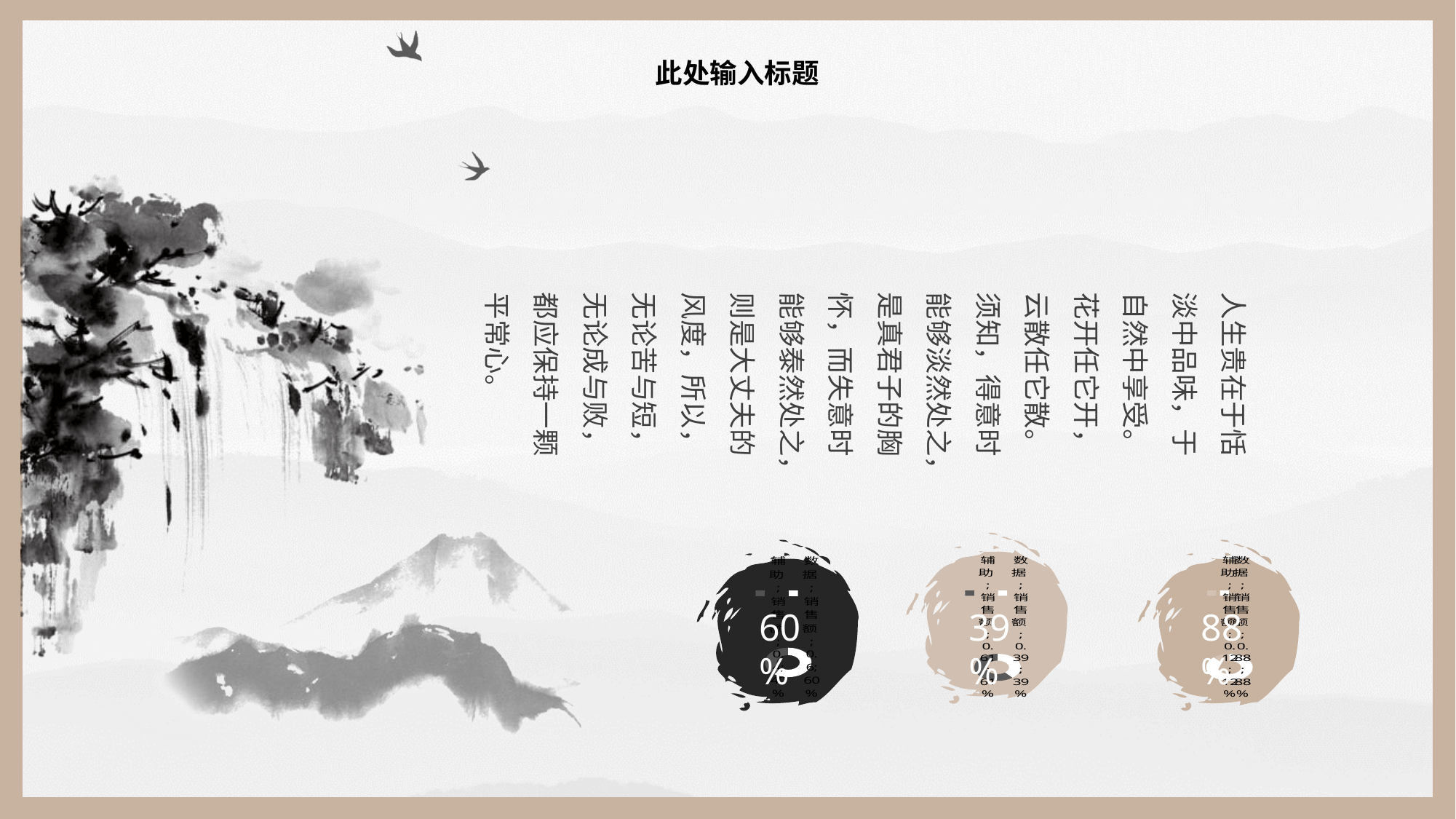
Is the percentage shown on the middle chart greater or less than 50%? less What colour is the left chart's circle compared with the other two? Dark grey/black; the other two are brown Which of the three charts shows the highest percentage? The right chart (88%) Which is larger, the percentage on the left chart or the percentage on the middle chart? The left chart (60%) Which of the three charts shows the lowest percentage? The middle chart (39%) What kind of chart is used in each of the three circles at the bottom right of the slide? Doughnut (pie) chart What is the difference between the percentage on the left chart and the percentage on the middle chart? 21 percentage points What percentage is shown on the left (dark) chart? 60% What percentage is shown on the right chart? 88% What is the difference between the percentage on the right chart and the percentage on the left chart? 28 percentage points What percentage is shown on the middle chart? 39% How many charts are shown on the slide? 3